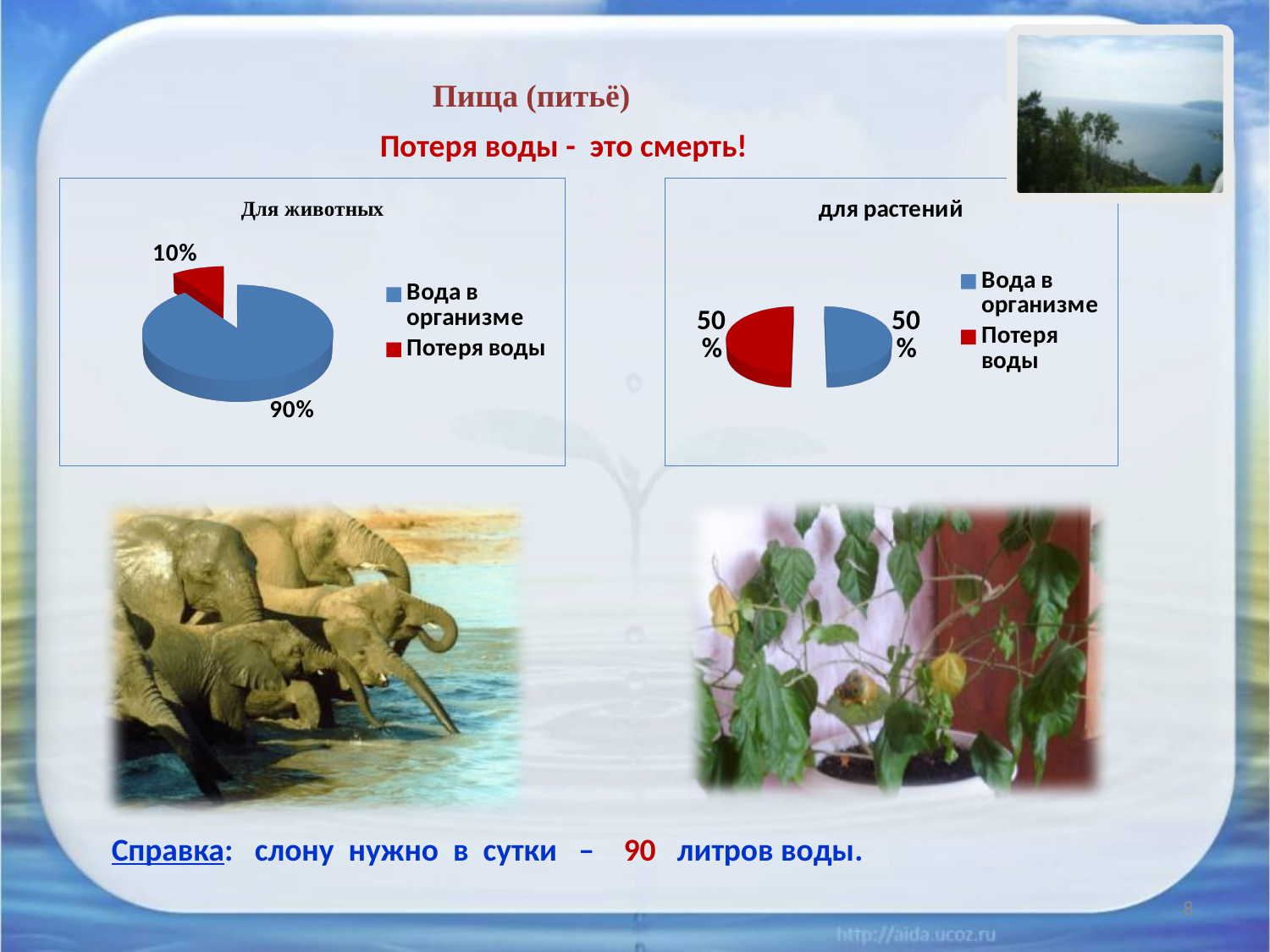
How many slices does the chart titled "Для животных" have? 2 In the chart titled "Для животных", what is the difference between the "Вода в организме" and "Потеря воды" slices? 80% How many entries does the legend of the chart titled "для растений" list? 2 In the chart titled "Для животных", which slice is the largest? Вода в организме What kind of chart is the chart titled "для растений"? Pie chart In the chart titled "Для животных", which slice is the smallest? Потеря воды In the chart titled "Для животных", what colour is the "Потеря воды" slice? Red In the chart titled "Для животных", what share of the pie is "Потеря воды"? 10% In the chart titled "Для животных", which is larger: "Вода в организме" or "Потеря воды"? Вода в организме In the chart titled "для растений", what share of the pie is "Вода в организме"? 50% In the chart titled "для растений", what share of the pie is "Потеря воды"? 50%